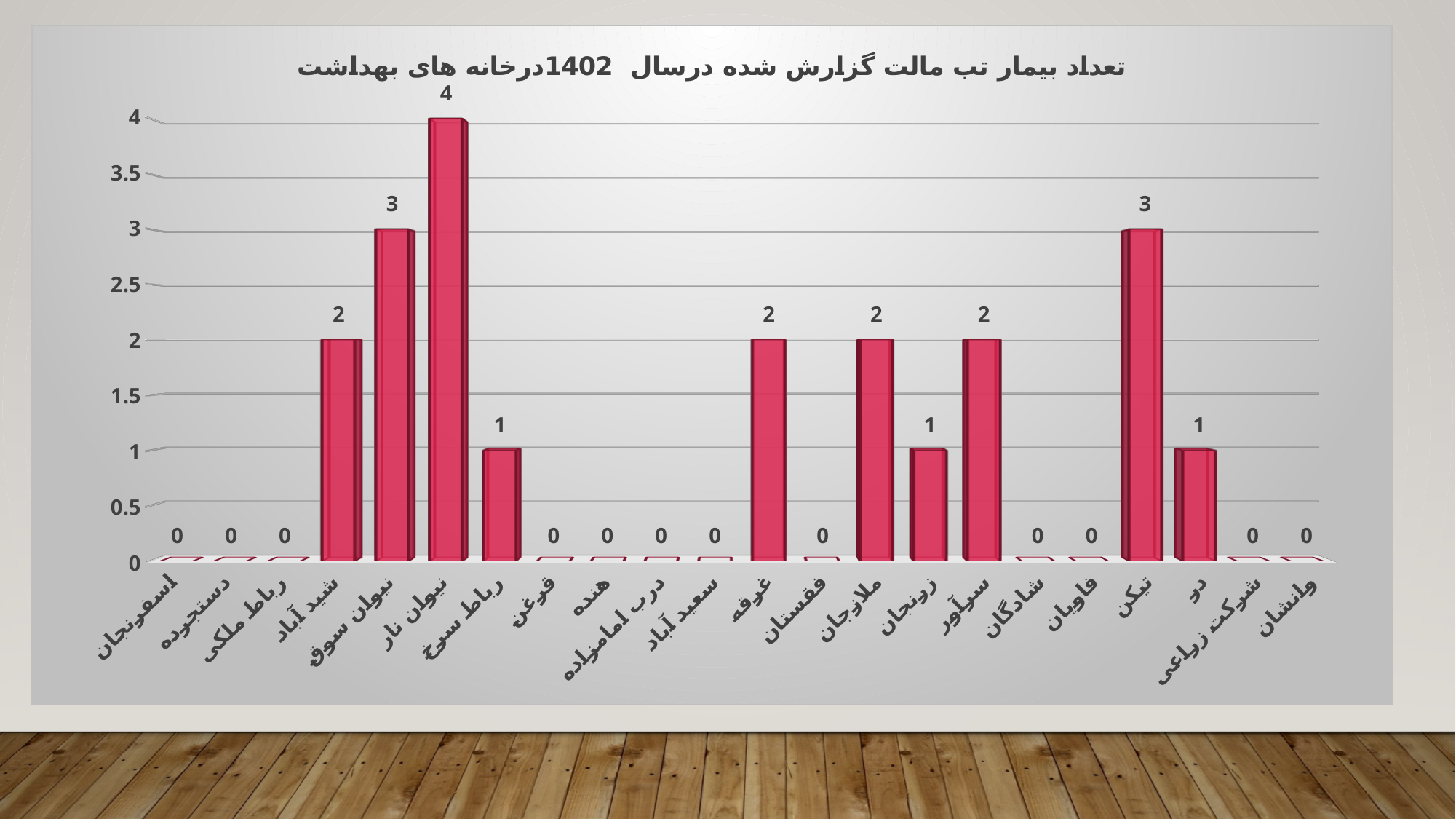
Which category has the highest value? نیوان نار What is the title of the chart? تعداد بیمار تب مالت گزارش شده درسال 1402 درخانه های بهداشت What is the value for نیوان نار? 4 What is the value for تیکن? 3 What type of chart is shown on the slide? bar chart How many categories have a value of 0? 12 What is the difference between the values for تیکن and در? 2 How many categories are shown on the x axis? 22 What is the value for غرقه? 2 What is the value for رباط سرخ? 1 What is the difference between the values for نیوان نار and نیوان سوق? 1 Which is larger, the value for شید آباد or the value for زرنجان? شید آباد